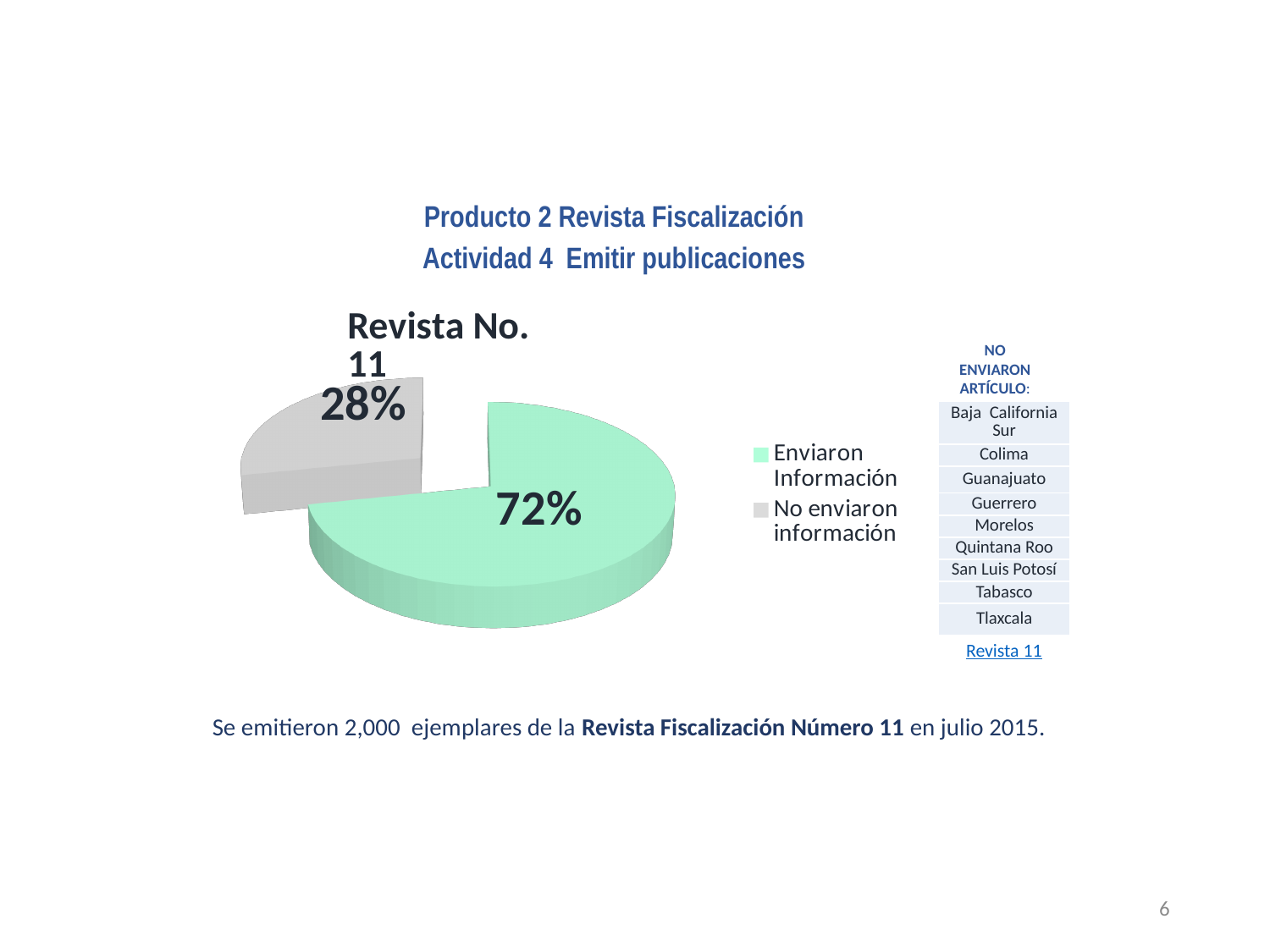
Which slice of the pie is the smallest? No enviaron información What is the difference in percentage points between the "Enviaron Información" and "No enviaron información" slices? 44 What kind of chart is shown on the slide? Pie chart What share of the pie is labelled "No enviaron información"? 28% What is the title of the chart? Revista No. 11 Which slice of the pie is the largest? Enviaron Información How many slices does the pie chart have? 2 What colour is the "Enviaron Información" slice? Green How many entries does the legend list? 2 What share of the pie is labelled "Enviaron Información"? 72% Which is larger: the "Enviaron Información" slice or the "No enviaron información" slice? Enviaron Información